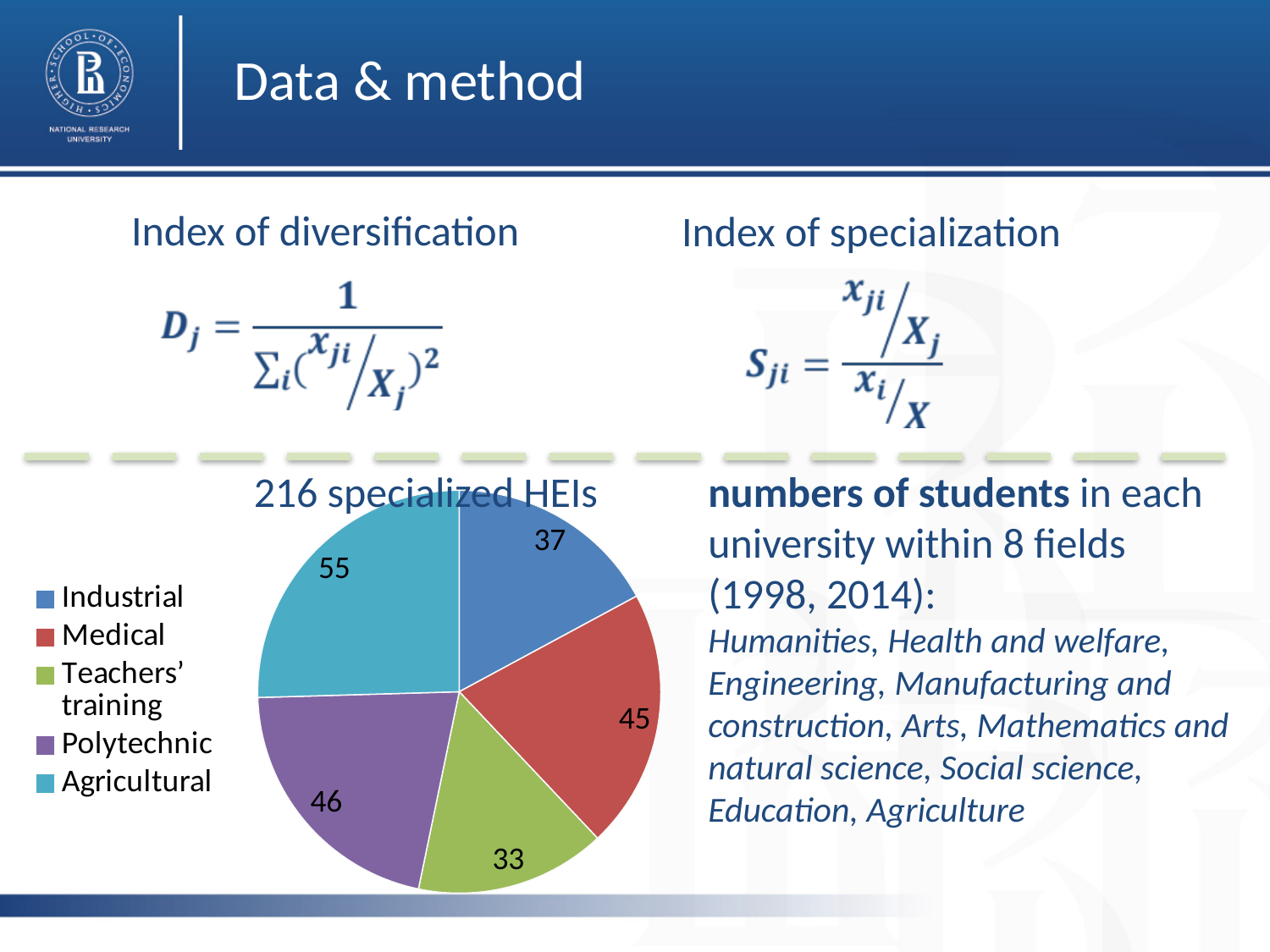
Which category has the smallest slice in the pie chart? Teachers' training What is the value for Agricultural in the pie chart? 55 Which is larger in the pie chart, the value for Polytechnic or the value for Medical? Polytechnic What type of chart is shown on the slide? pie chart Which category has the largest slice in the pie chart? Agricultural What is the value for Teachers' training in the pie chart? 33 What is the difference between the Agricultural and Teachers' training values in the pie chart? 22 What is the value for Medical in the pie chart? 45 What is the value for Industrial in the pie chart? 37 What is the title of the pie chart? 216 specialized HEIs How many categories does the pie chart show? 5 What is the value for Polytechnic in the pie chart? 46